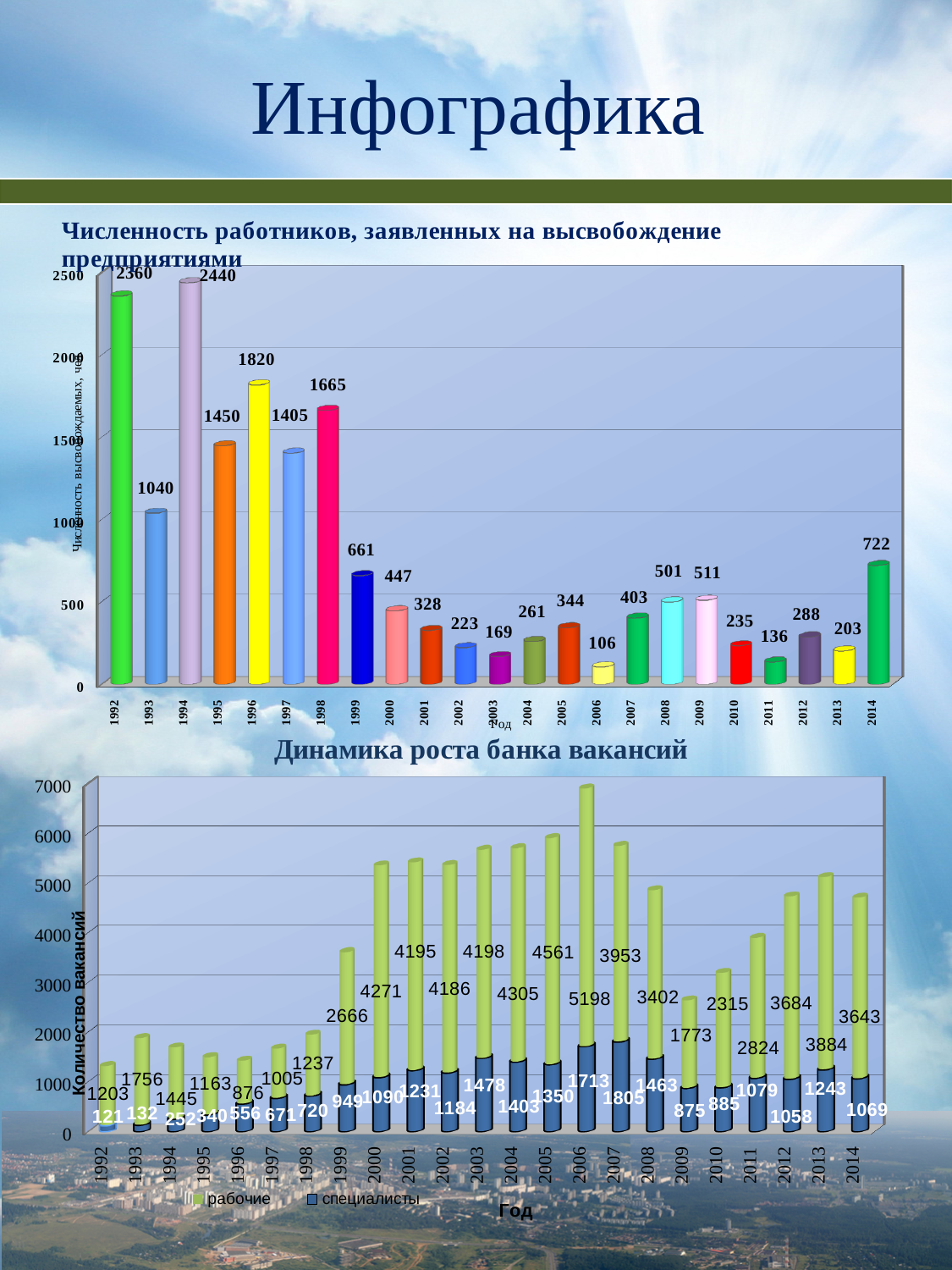
In the top chart (Численность работников, заявленных на высвобождение предприятиями), is the value for 2014 greater or less than 500? greater In the top chart (Численность работников, заявленных на высвобождение предприятиями), how many years are shown on the x axis? 23 In the bottom chart (Динамика роста банка вакансий), what is the value for рабочие in 2006? 5198 In the bottom chart (Динамика роста банка вакансий), which is larger: рабочие in 2000 or рабочие in 2009? рабочие in 2000 In the top chart (Численность работников, заявленных на высвобождение предприятиями), which year has the highest value? 1994 What kind of chart is the bottom chart (Динамика роста банка вакансий)? stacked bar chart In the bottom chart (Динамика роста банка вакансий), what is the value for специалисты in 2007? 1805 In the bottom chart (Динамика роста банка вакансий), what is the total of the stacked bar for 2006? 6911 In the bottom chart (Динамика роста банка вакансий), how many series does the legend list? 2 In the top chart (Численность работников, заявленных на высвобождение предприятиями), what is the value for 1996? 1820 In the top chart (Численность работников, заявленных на высвобождение предприятиями), which year has the lowest value? 2006 In the top chart (Численность работников, заявленных на высвобождение предприятиями), what is the difference between the values for 1994 and 1992? 80